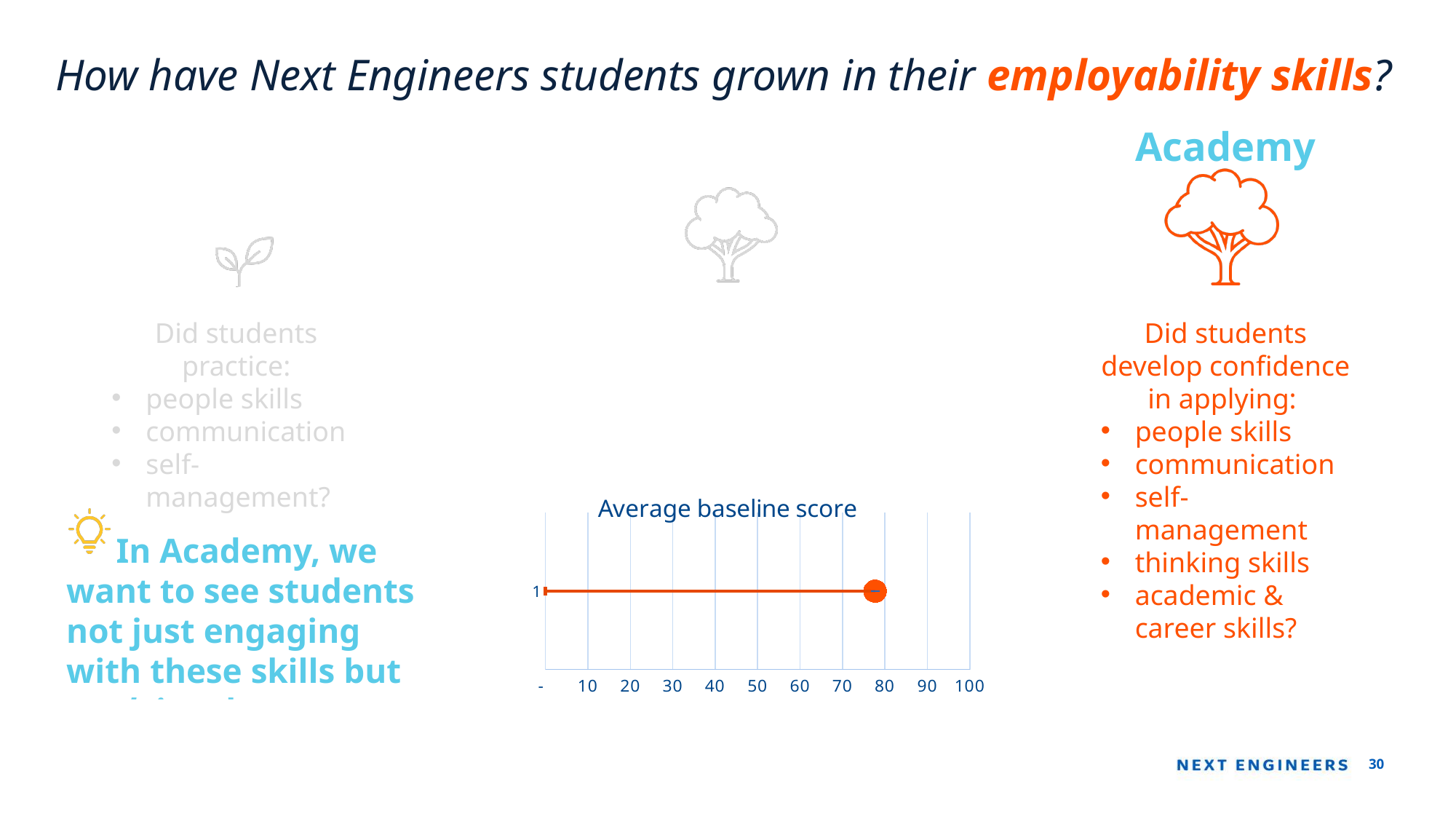
What is the highest value shown on the x axis of the "Average baseline score" chart? 100 In the "Average baseline score" chart, is the plotted value greater or less than 90? less How many categories are plotted in the "Average baseline score" chart? 1 In the "Average baseline score" chart, is the plotted value greater or less than 70? greater What is the title of the chart on the slide? Average baseline score In the "Average baseline score" chart, is the plotted value greater or less than 50? greater